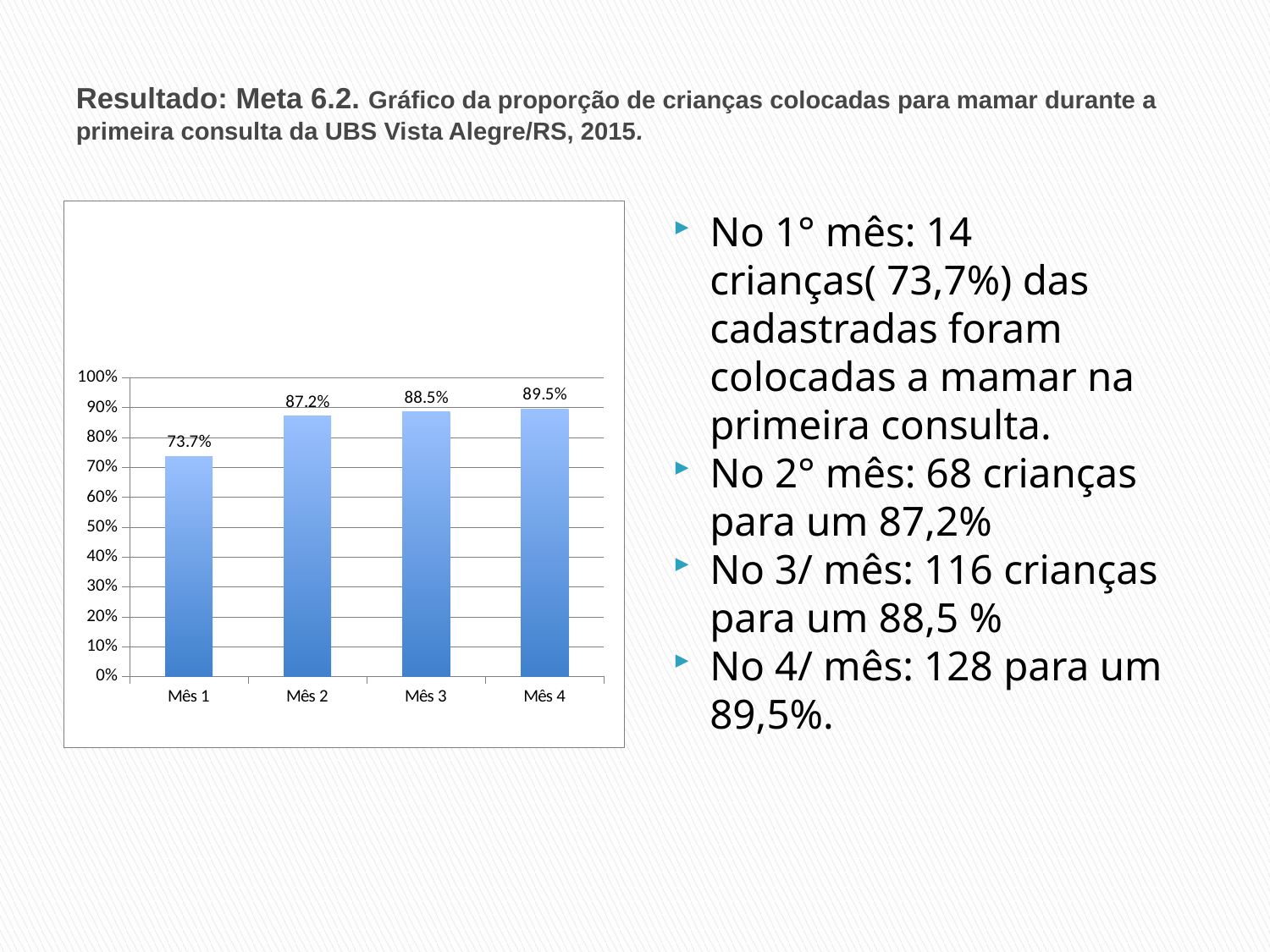
What is the value for Mês 3? 88.5% What kind of chart is shown on the slide? bar chart Which month has the lowest value? Mês 1 Which is larger, the value for Mês 2 or the value for Mês 1? Mês 2 Is the value for Mês 1 greater or less than 80%? less What is the difference between the values for Mês 4 and Mês 1? 15.8% What is the value for Mês 4? 89.5% What is the value for Mês 1? 73.7% Do the values rise or fall from Mês 1 to Mês 4? rise How many months are shown on the x axis of the chart? 4 Which month has the highest value? Mês 4 What is the difference between the values for Mês 2 and Mês 1? 13.5%